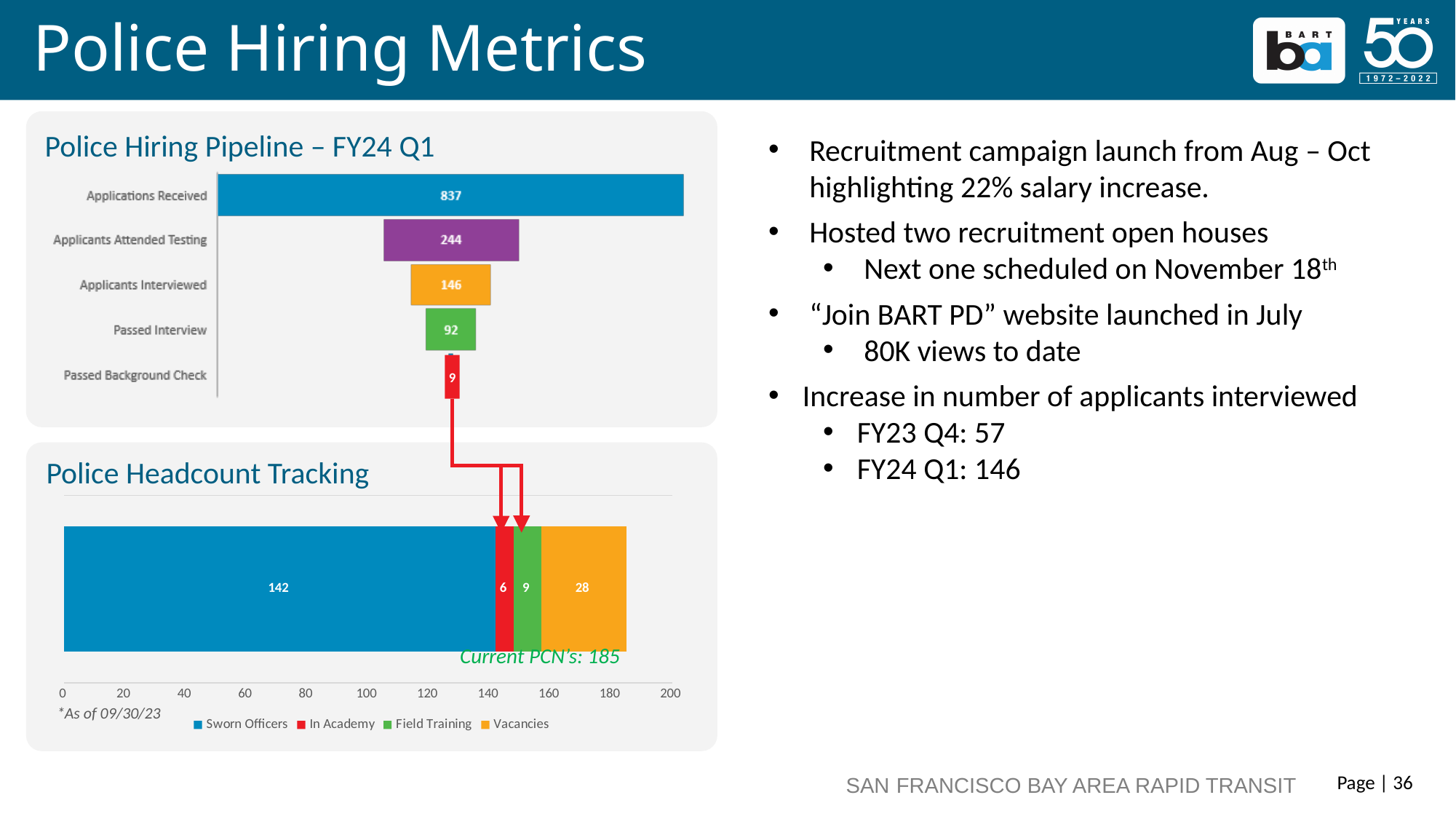
In the Police Hiring Pipeline – FY24 Q1 chart, what is the value for Applicants Attended Testing? 244 In the Police Hiring Pipeline – FY24 Q1 chart, do the values rise or fall from the top stage to the bottom stage? fall In the Police Headcount Tracking chart, what is the total of the stacked bar? 185 In the Police Hiring Pipeline – FY24 Q1 chart, what is the difference between Applicants Interviewed and Passed Interview? 54 In the Police Headcount Tracking chart, what is the value for Sworn Officers? 142 In the Police Headcount Tracking chart, which is larger: In Academy or Field Training? Field Training In the Police Hiring Pipeline – FY24 Q1 chart, which stage has the lowest value? Passed Background Check In the Police Hiring Pipeline – FY24 Q1 chart, how many stages are shown? 5 In the Police Hiring Pipeline – FY24 Q1 chart, what is the value for Passed Background Check? 9 In the Police Headcount Tracking chart, what is the value for Vacancies? 28 In the Police Headcount Tracking chart, how many series does the legend list? 4 In the Police Hiring Pipeline – FY24 Q1 chart, how many Applications Received are shown? 837